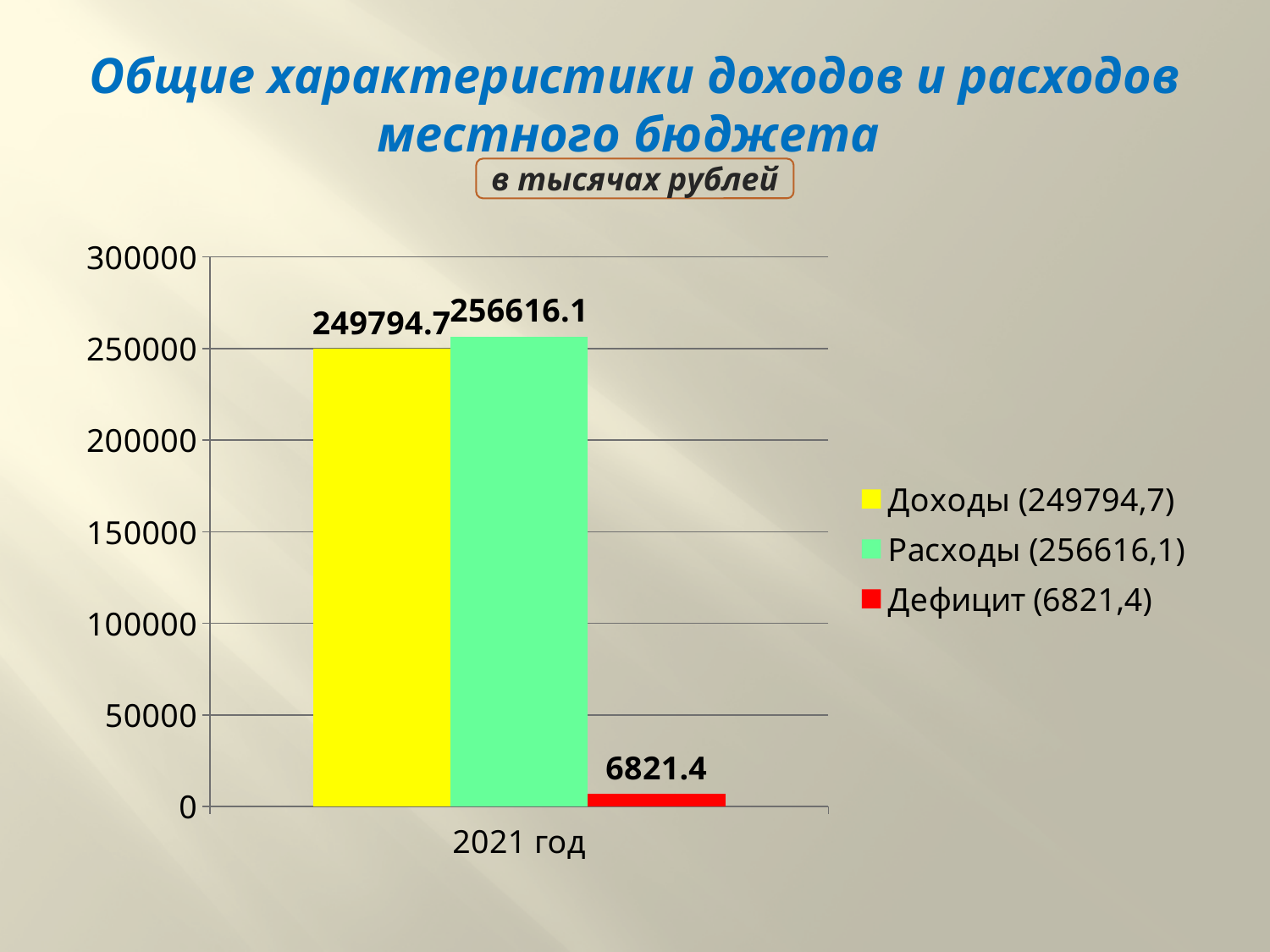
What is the difference between the Расходы and Доходы values? 6821.4 What is the value of the Доходы bar for 2021 год? 249794.7 Which series has the highest value in the chart? Расходы Is the value for Расходы greater or less than 250000? greater Which series has the lowest value in the chart? Дефицит How many series does the legend list? 3 Is the value for Дефицит greater or less than 50000? less What is the value of the Расходы bar for 2021 год? 256616.1 Which is larger, Доходы or Расходы? Расходы What is the value of the Дефицит bar for 2021 год? 6821.4 What kind of chart is shown on the slide? bar chart What colour is the Дефицит bar? red